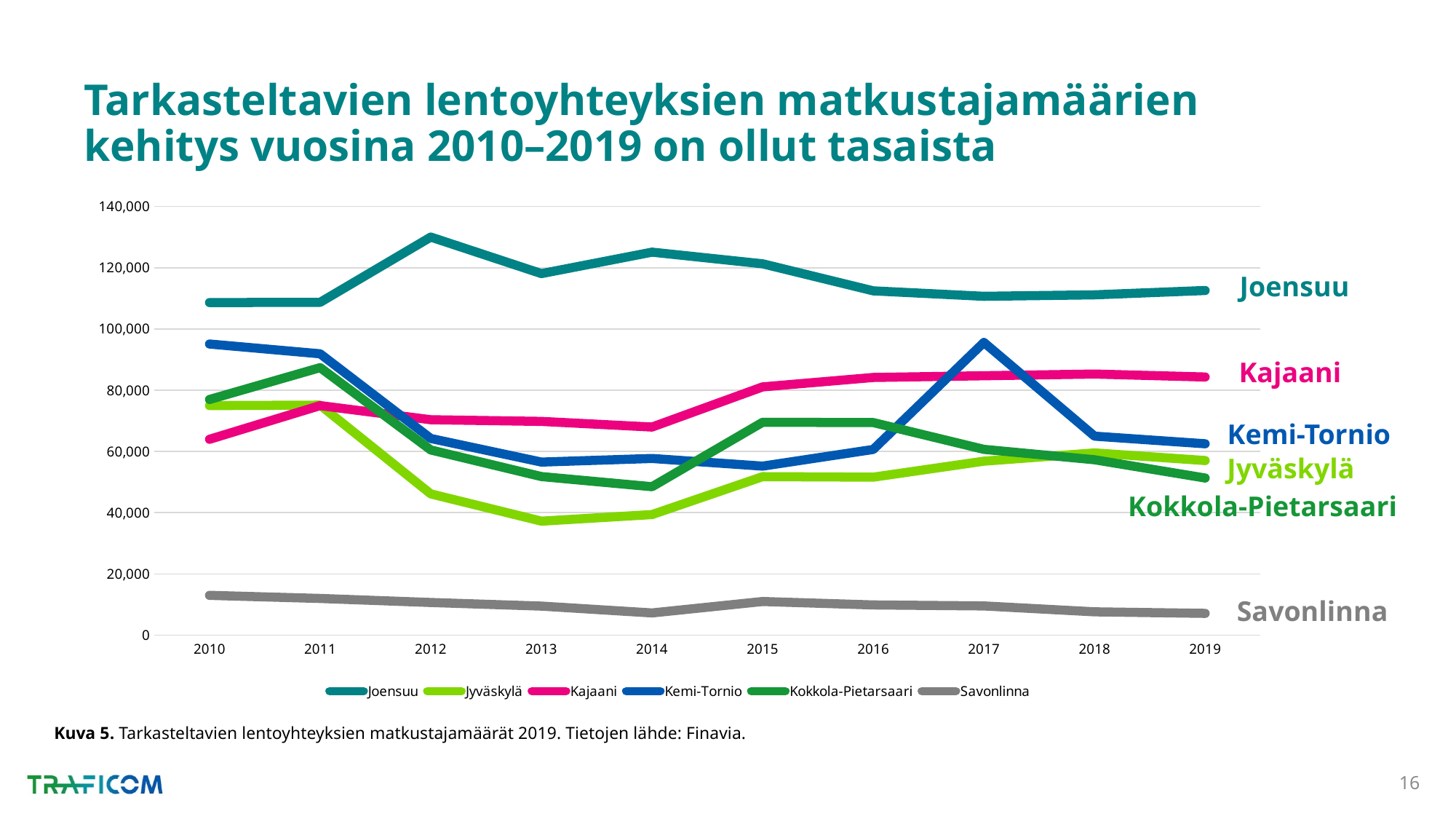
Which series has the highest value in 2019? Joensuu Which series has the lowest value in 2019? Savonlinna Does the Jyväskylä line rise or fall from 2011 to 2013? fall How many series does the legend list? 6 What kind of chart is shown on the slide? line chart Is the value for Savonlinna in 2014 greater or less than 20,000? less Is the value for Joensuu in 2012 greater or less than 120,000? greater Is the value for Jyväskylä in 2013 greater or less than 40,000? less How many years are shown on the x axis? 10 What colour is the Savonlinna line? grey In 2010, which is larger: the value for Kemi-Tornio or the value for Kajaani? Kemi-Tornio